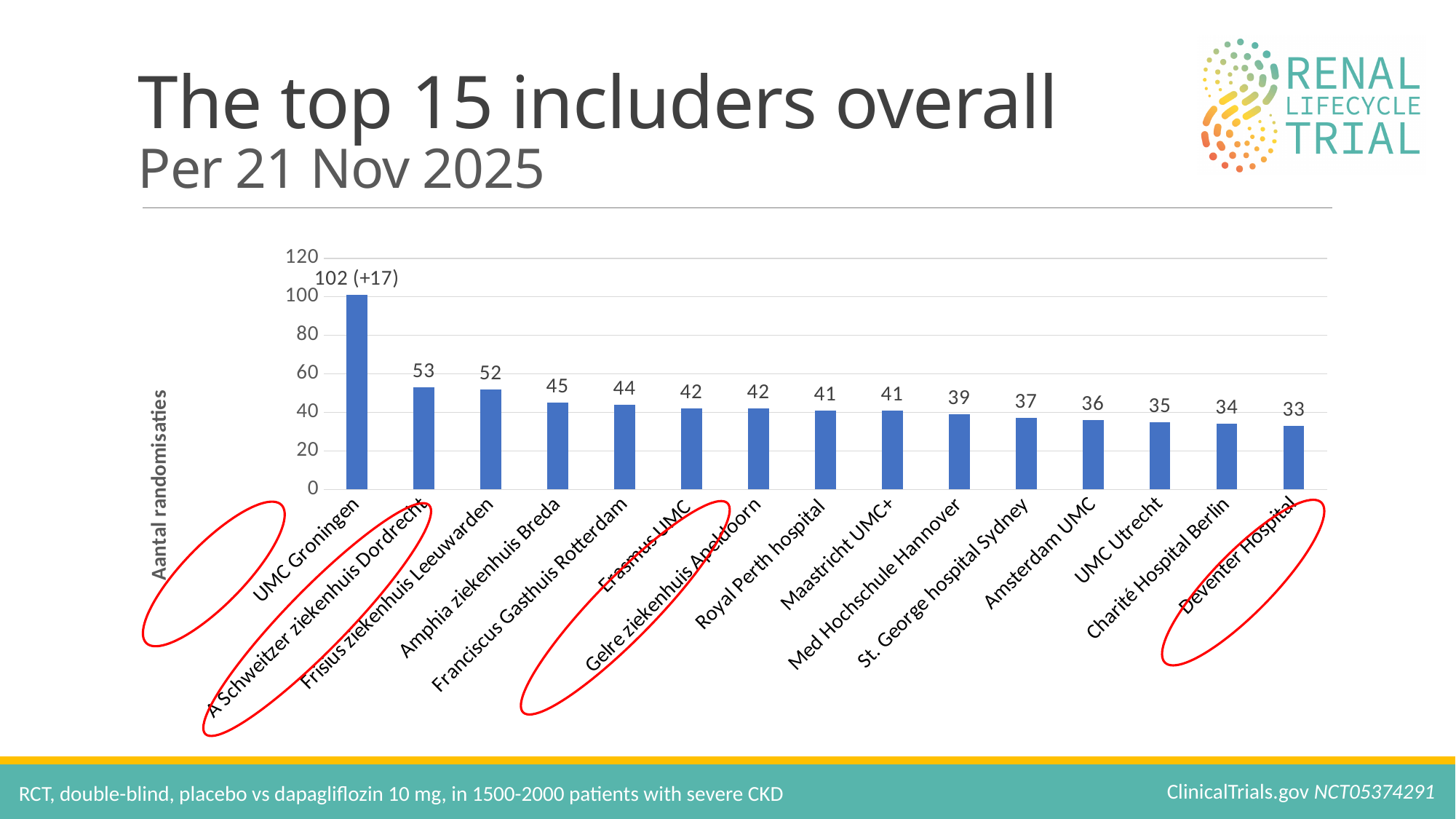
What is the difference between the values for UMC Groningen and A Schweitzer ziekenhuis Dordrecht? 49 Which is larger, the value for Franciscus Gasthuis Rotterdam or the value for Amsterdam UMC? Franciscus Gasthuis Rotterdam Which category has the lowest value? Deventer Hospital What is the difference between the values for Frisius ziekenhuis Leeuwarden and UMC Utrecht? 17 What is the label of the vertical axis? Aantal randomisaties What is the value for UMC Groningen? 102 Which category has the highest value? UMC Groningen How many categories are shown on the x axis? 15 What is the value for Amphia ziekenhuis Breda? 45 What is the value for Deventer Hospital? 33 What kind of chart is shown on the slide? Bar chart What is the value for Med Hochschule Hannover? 39